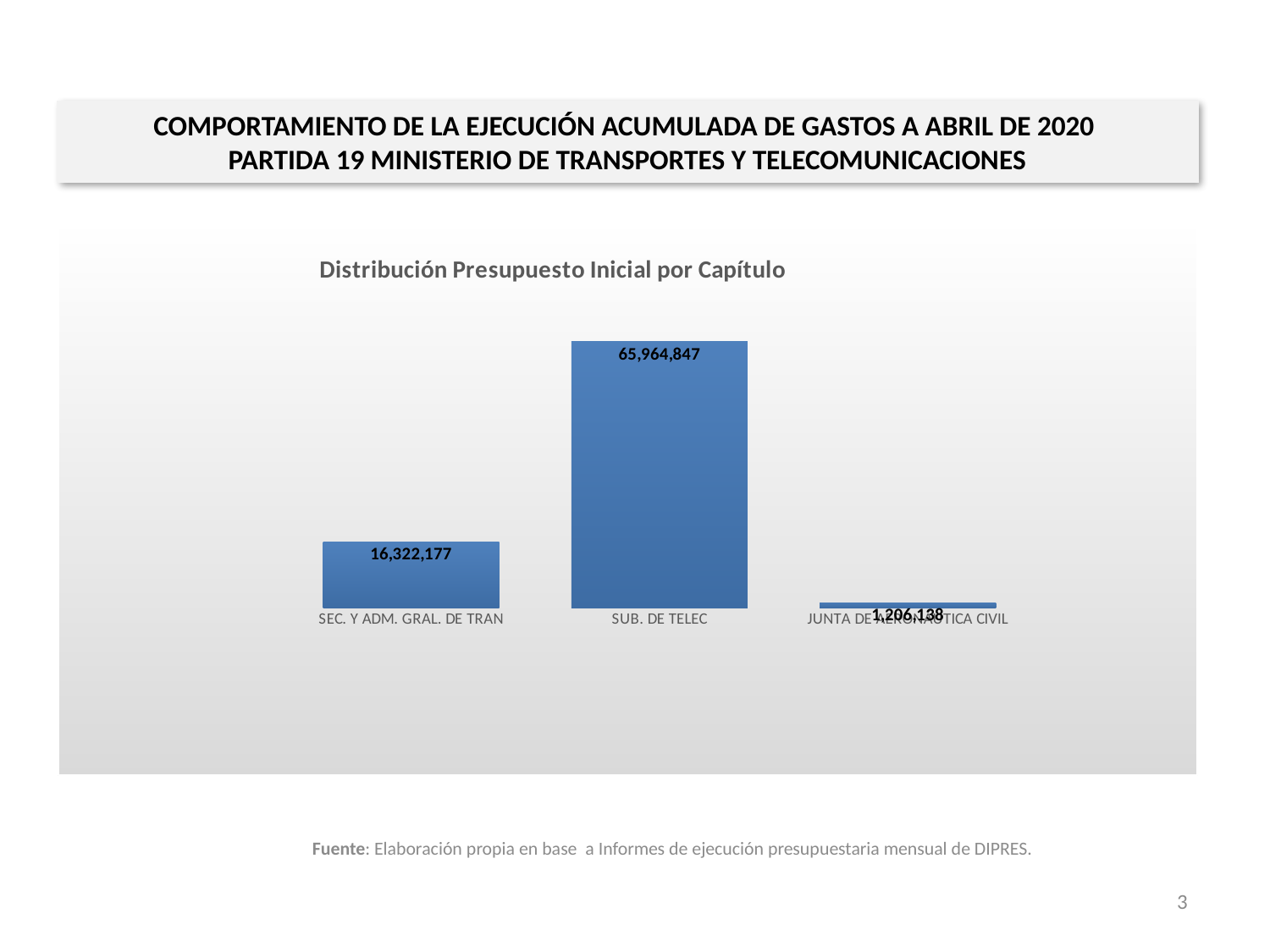
What is the difference between the values for SUB. DE TELEC and SEC. Y ADM. GRAL. DE TRAN? 49,642,670 What is the sum of the three values shown in the chart? 83,493,162 Which category has the lowest value in the chart? JUNTA DE AERONÁUTICA CIVIL What is the difference between the values for SEC. Y ADM. GRAL. DE TRAN and JUNTA DE AERONÁUTICA CIVIL? 15,116,039 What kind of chart is shown on the slide? Bar chart How many categories are shown in the chart? 3 Which is larger, the value for SEC. Y ADM. GRAL. DE TRAN or the value for JUNTA DE AERONÁUTICA CIVIL? SEC. Y ADM. GRAL. DE TRAN What is the value for JUNTA DE AERONÁUTICA CIVIL in the chart? 1,206,138 What is the value for SEC. Y ADM. GRAL. DE TRAN in the chart? 16,322,177 What is the value for SUB. DE TELEC in the chart? 65,964,847 Which category has the highest value in the chart? SUB. DE TELEC What is the title of the chart? Distribución Presupuesto Inicial por Capítulo